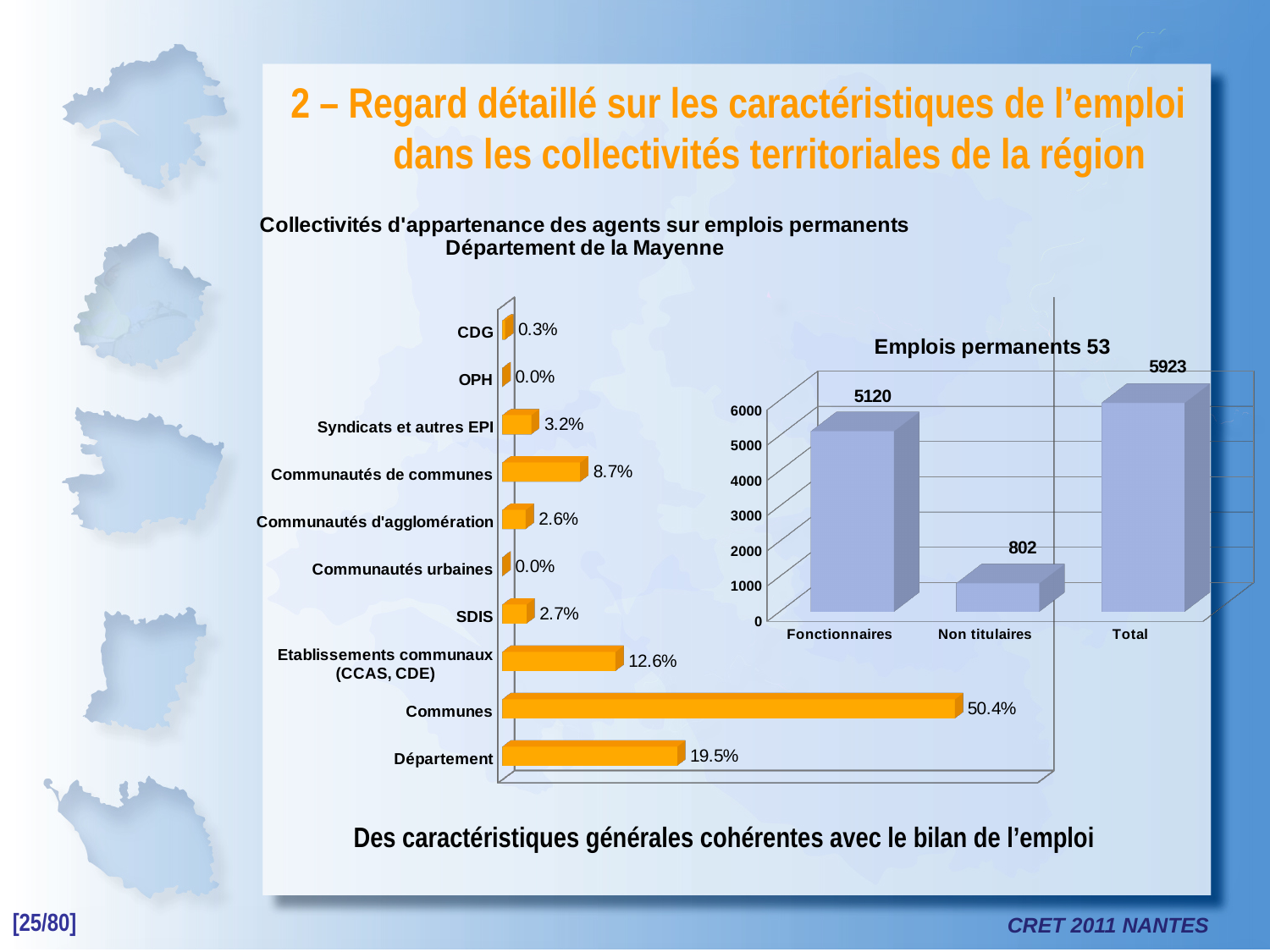
In the chart 'Collectivités d'appartenance des agents sur emplois permanents', what is the value for Département? 19.5% In the chart 'Collectivités d'appartenance des agents sur emplois permanents', what is the value for Communes? 50.4% In the chart 'Collectivités d'appartenance des agents sur emplois permanents', what is the difference between Communes and Département? 30.9% What kind of chart is 'Emplois permanents 53'? Bar chart In the chart 'Emplois permanents 53', which category has the lowest value? Non titulaires In the chart 'Emplois permanents 53', what is the difference between Fonctionnaires and Non titulaires? 4318 In the chart 'Emplois permanents 53', what is the value for Non titulaires? 802 In the chart 'Collectivités d'appartenance des agents sur emplois permanents', which category has the highest value? Communes In the chart 'Collectivités d'appartenance des agents sur emplois permanents', which is larger: Etablissements communaux (CCAS, CDE) or Syndicats et autres EPI? Etablissements communaux (CCAS, CDE) In the chart 'Emplois permanents 53', what is the value for Fonctionnaires? 5120 In the chart 'Collectivités d'appartenance des agents sur emplois permanents', what is the value for Communautés de communes? 8.7% In the chart 'Collectivités d'appartenance des agents sur emplois permanents', how many categories are shown? 10